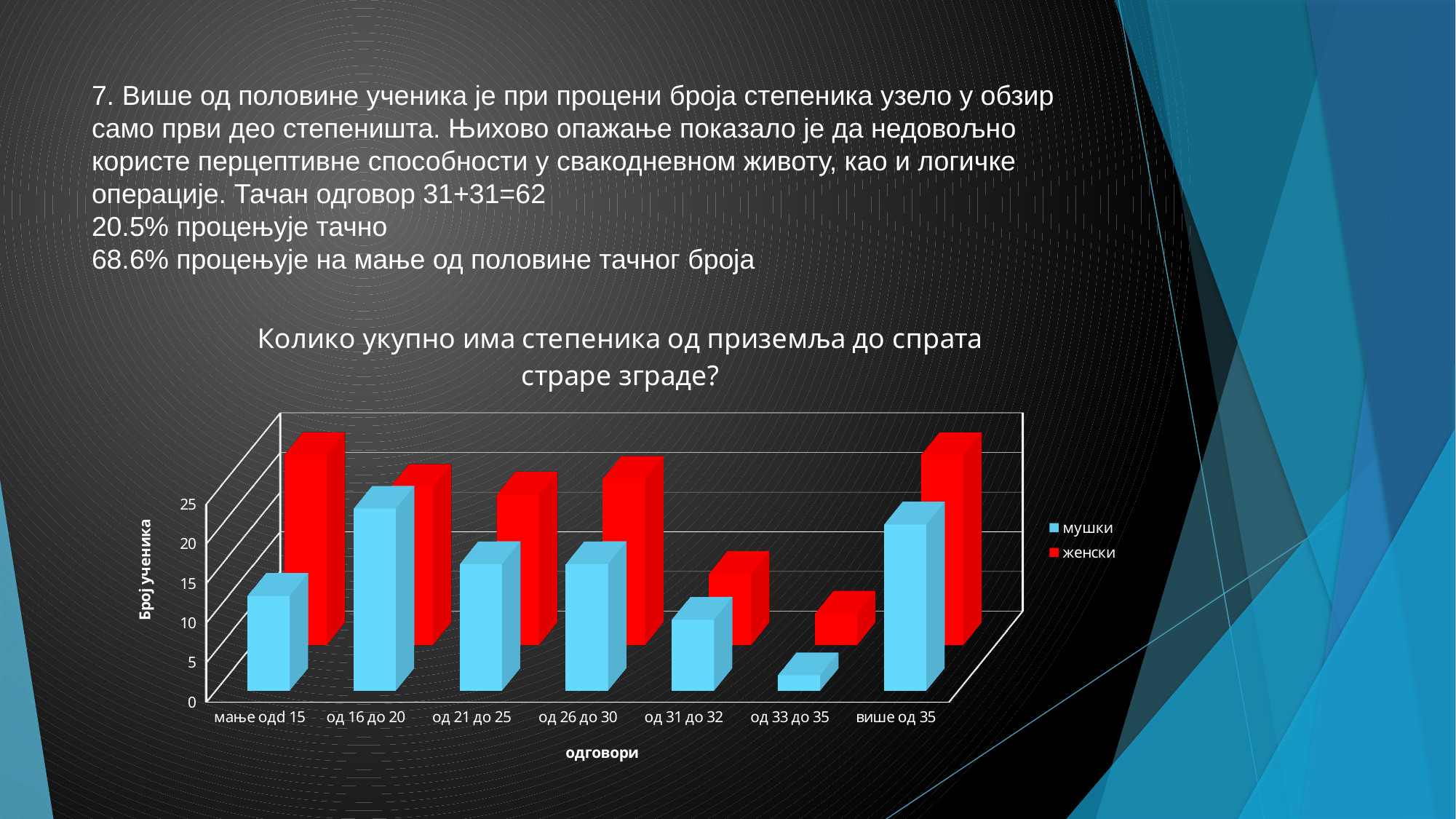
Is the мушки value for од 33 до 35 greater or less than 5? less For the category мање одд 15, which series has the larger value, мушки or женски? женски For which category is the мушки value lowest? од 33 до 35 How many series does the chart legend list? 2 Is the мушки value for од 31 до 32 greater or less than 15? less What kind of chart is shown on the slide? bar chart For which category is the женски value lowest? од 33 до 35 What are the two series listed in the chart legend? мушки, женски Is the мушки value for од 16 до 20 greater or less than 20? greater How many answer categories are shown on the x axis of the chart? 7 What is the label of the chart's y axis? Број ученика Which is larger for мушки: од 21 до 25 or од 33 до 35? од 21 до 25